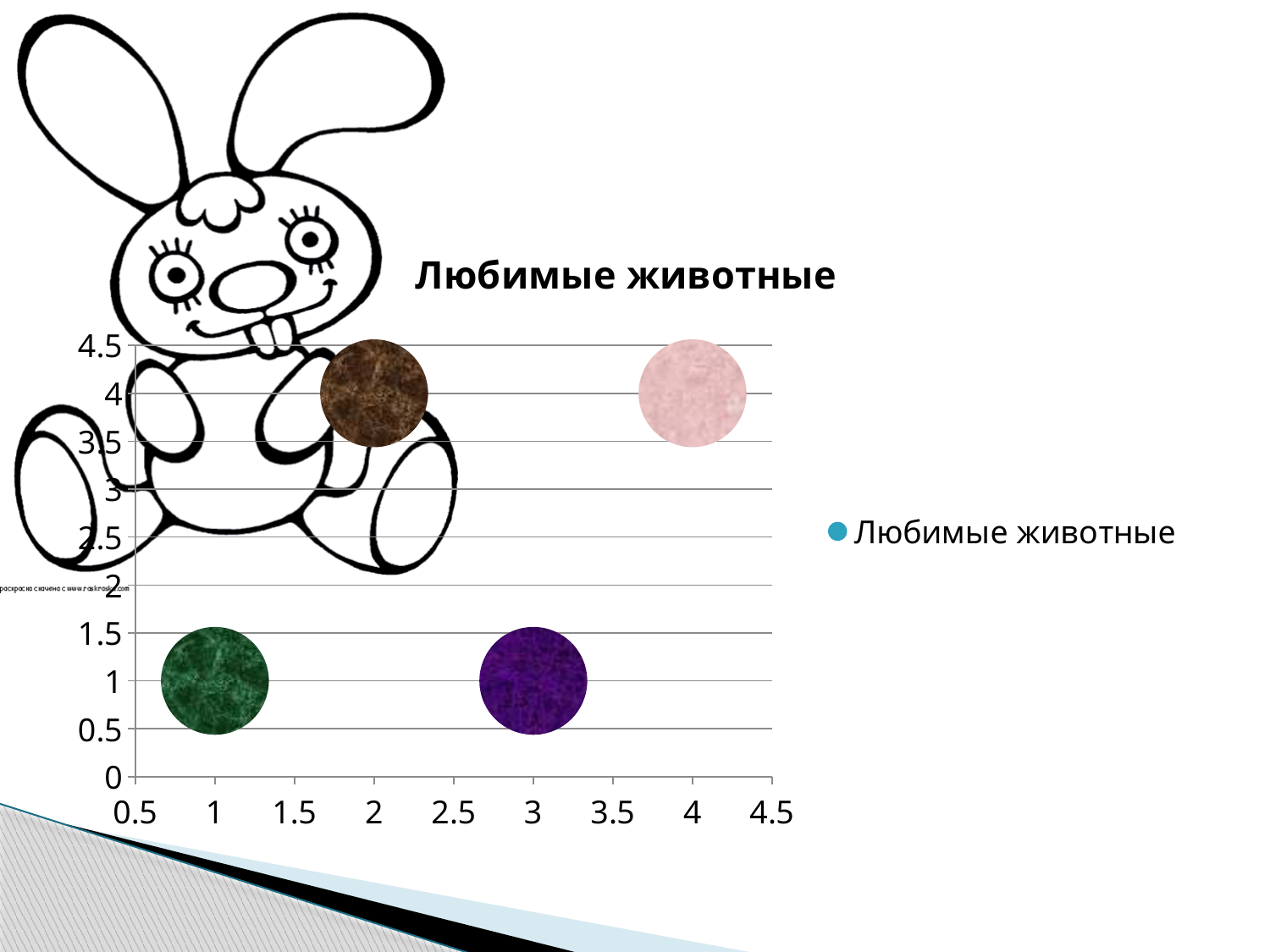
How many series does the legend list? 1 What is the y value of the point at x = 1? 1 What is the difference between the y value of the point at x = 4 and the y value of the point at x = 1? 3 How many data points are plotted on the chart? 4 What is the y value of the point at x = 4? 4 What is the y value of the point at x = 3? 1 What is the y value of the point at x = 2? 4 Which is larger, the y value of the point at x = 2 or the y value of the point at x = 3? the point at x = 2 Is the y value of the point at x = 4 greater or less than 3? greater What is the highest y value plotted on the chart? 4 What is the title of the chart? Любимые животные What kind of chart is shown on the slide? bubble chart